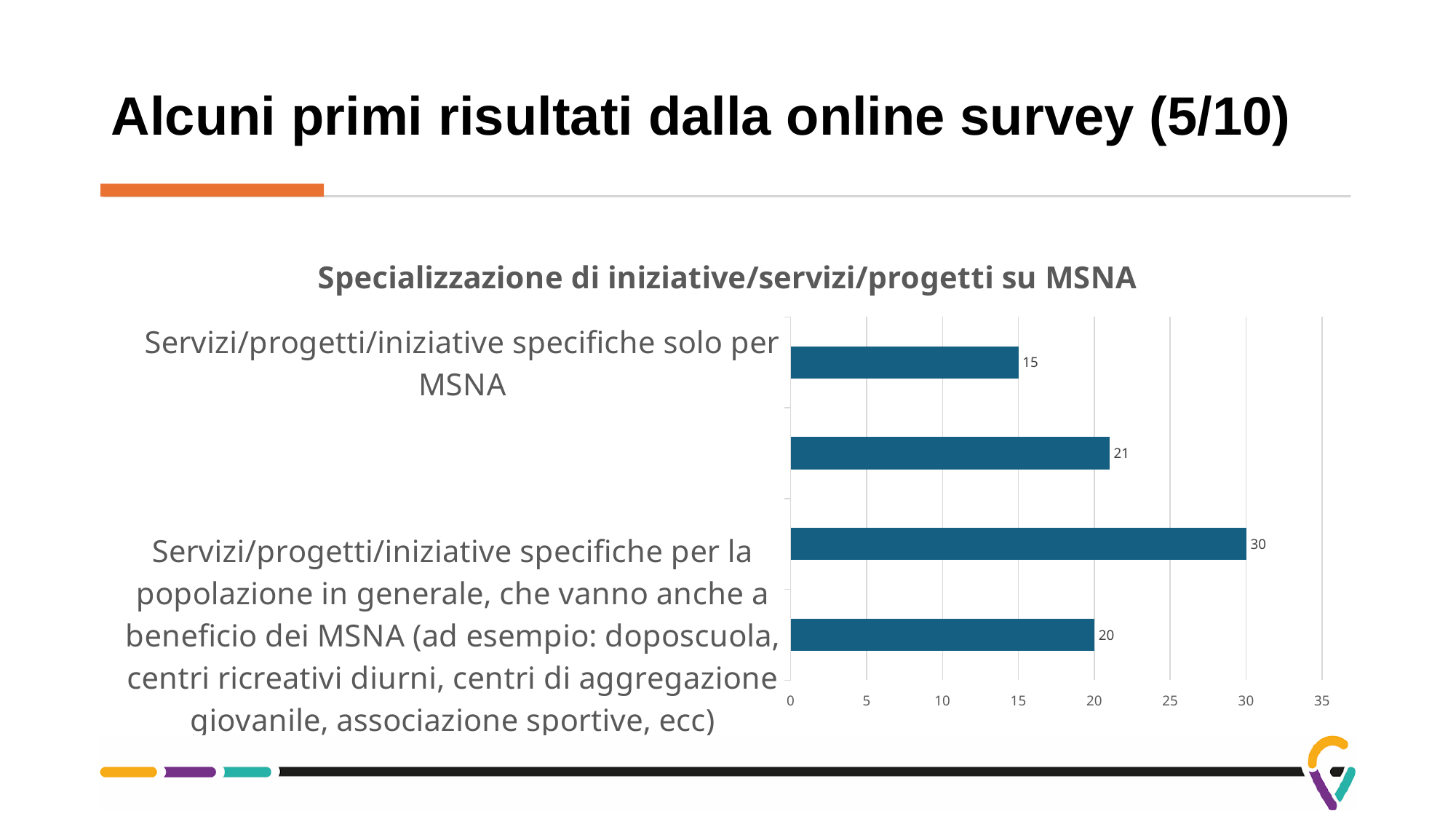
What is the difference between the highest and lowest values in the chart? 15 What is the value of the bottom bar in the chart? 20 What type of chart is shown on the slide? bar chart What is the maximum value shown on the horizontal axis? 35 What is the highest value shown in the chart? 30 What is the lowest value shown in the chart? 15 What is the value for 'Servizi/progetti/iniziative specifiche solo per MSNA'? 15 How many bars are plotted in the chart? 4 Is the value for 'Servizi/progetti/iniziative specifiche solo per MSNA' greater or less than 20? less What is the title of the chart? Specializzazione di iniziative/servizi/progetti su MSNA Which is larger: the value of the top bar or the value of the bottom bar? the bottom bar What is the value of the second bar from the top? 21